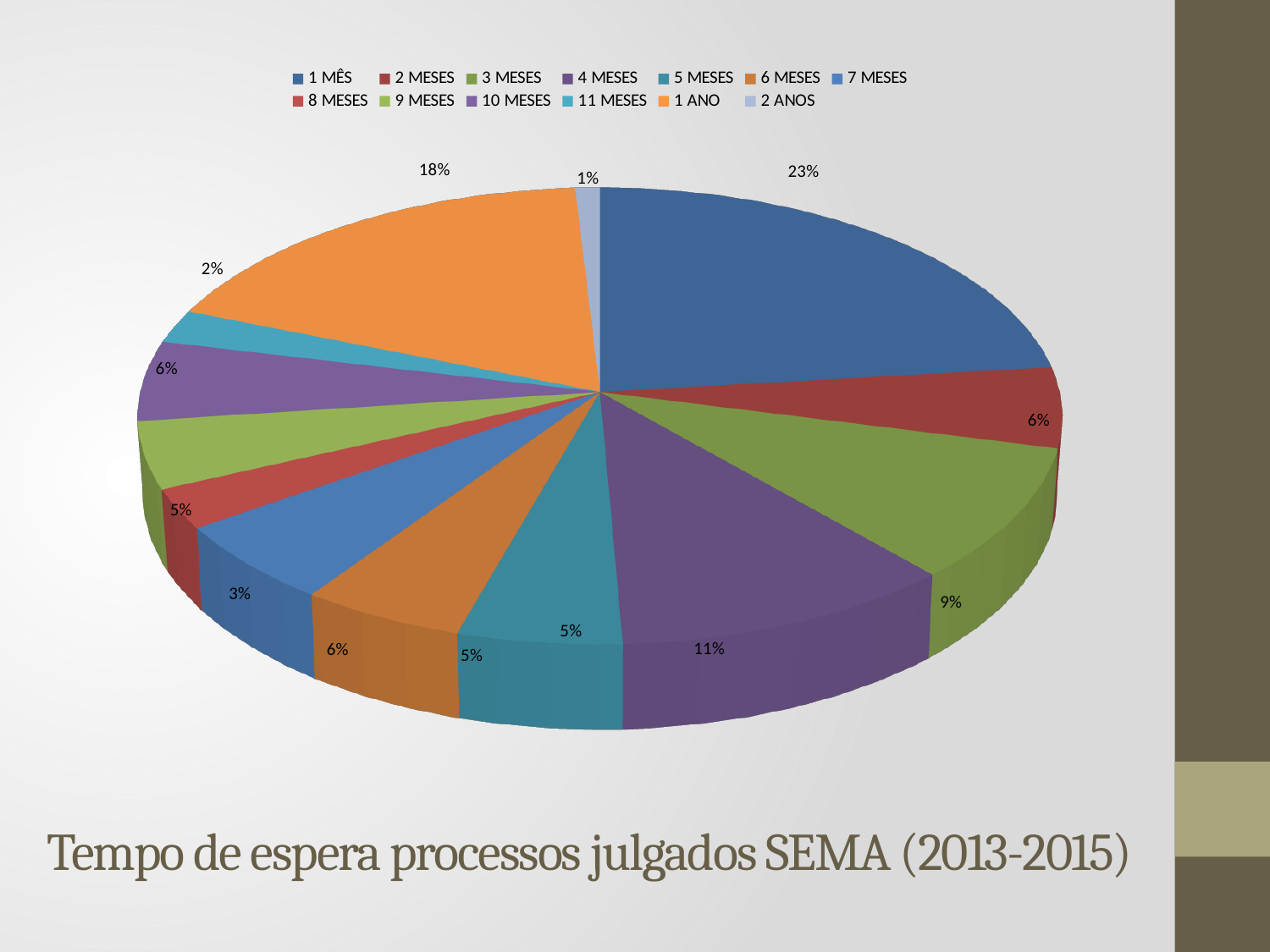
What is the difference between the shares for 1 MÊS and 1 ANO? 5 percentage points Which category has the largest share of the pie? 1 MÊS What is the value for 2 ANOS? 1% What is the value for 3 MESES? 9% Which category has the smallest share of the pie? 2 ANOS How many categories does the legend list? 13 What share of the pie does 1 ANO represent? 18% What is the value for 4 MESES? 11% What is the title of the chart? Tempo de espera processos julgados SEMA (2013-2015) What kind of chart is shown on the slide? pie chart Which is larger, the share for 1 ANO or the share for 4 MESES? 1 ANO What share of the pie does 1 MÊS represent? 23%